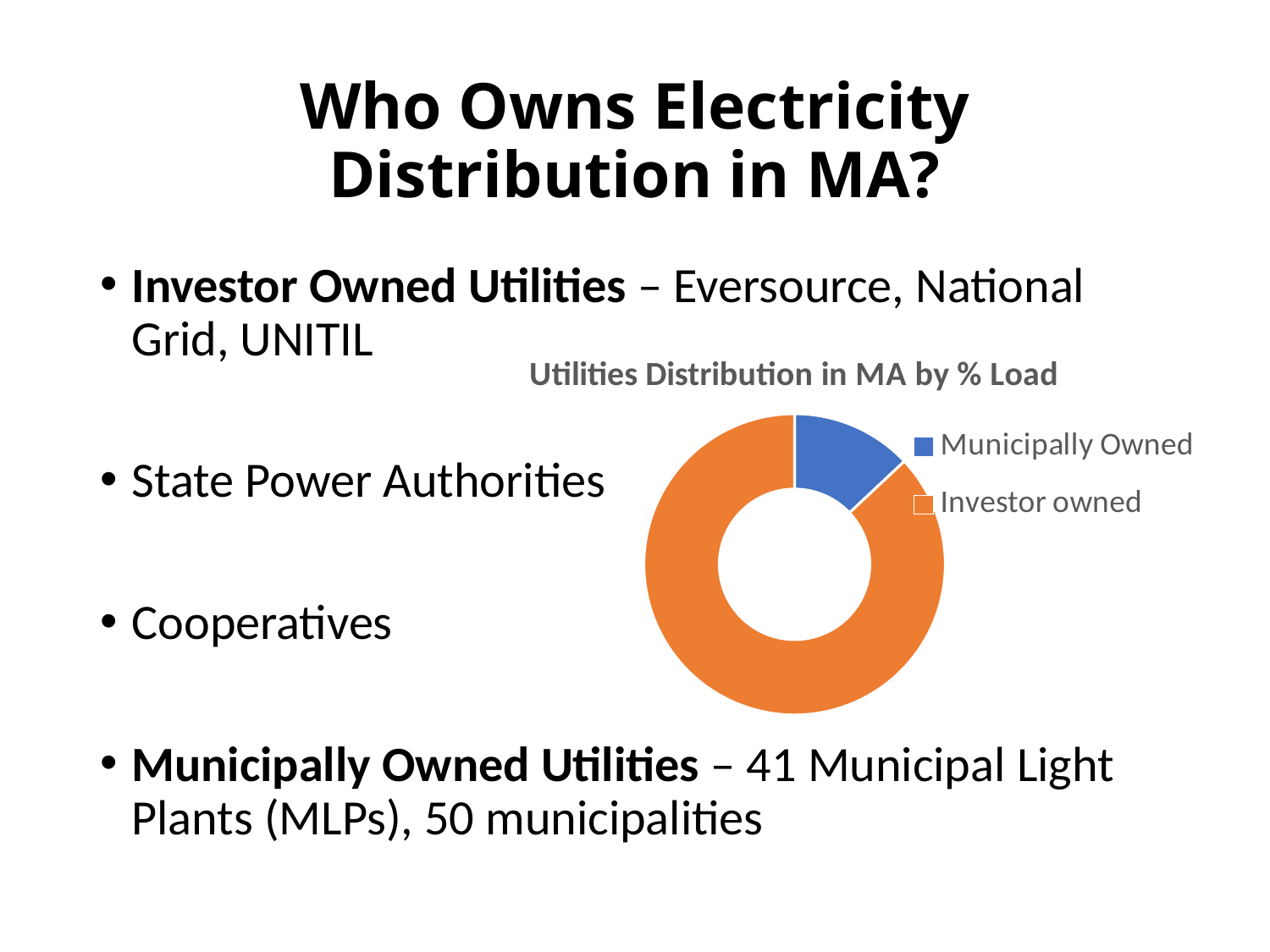
How many categories does the chart's legend list? 2 Which category has the largest share of the chart? Investor owned Which is larger, the share for Municipally Owned or the share for Investor owned? Investor owned Is the share for Municipally Owned greater or less than 50%? less What is the title of the chart? Utilities Distribution in MA by % Load Is the share for Investor owned greater or less than 50%? greater Which category has the smallest share of the chart? Municipally Owned What kind of chart is shown on the slide? doughnut chart What colour represents Investor owned in the chart? orange